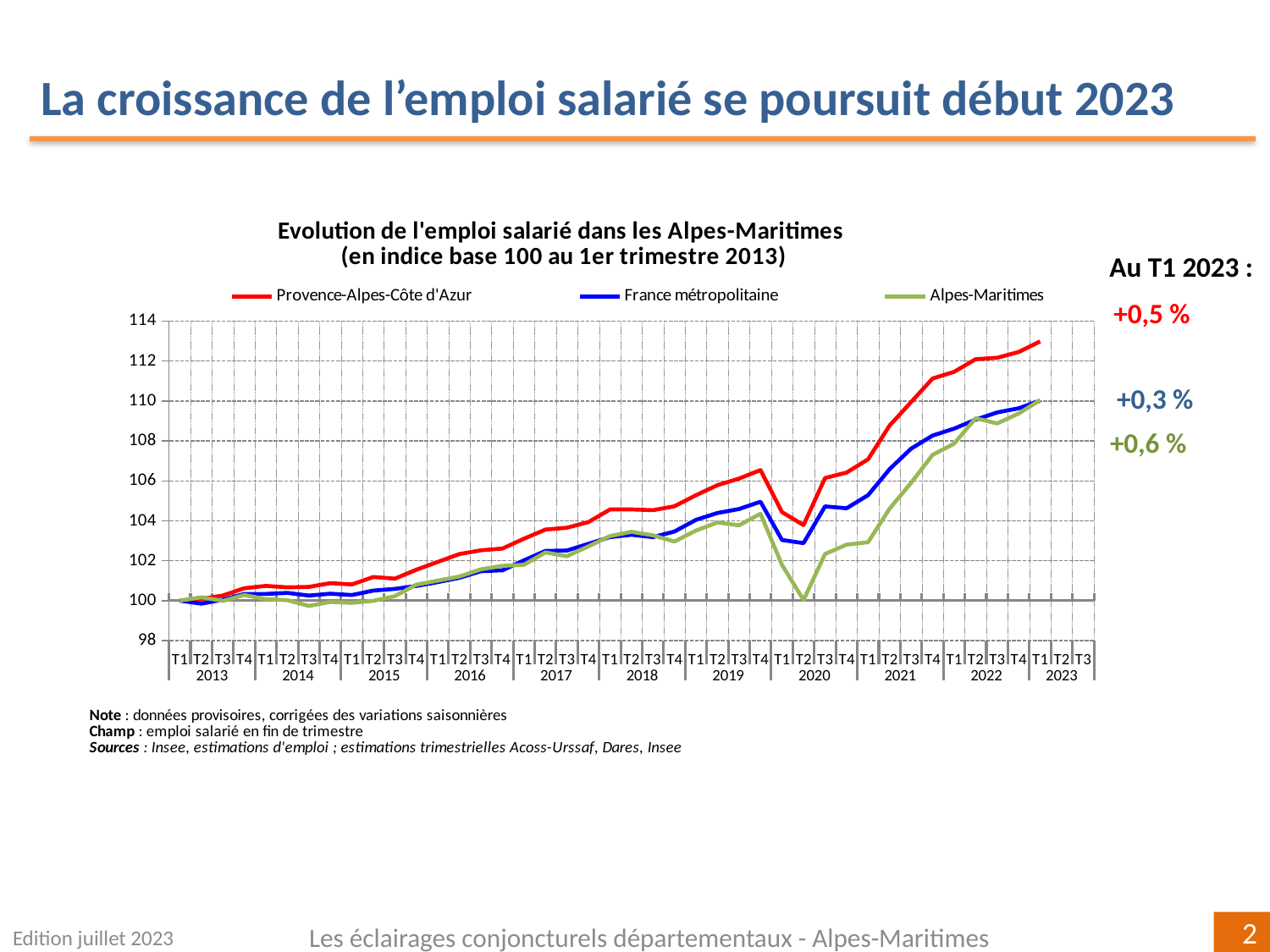
Which series has the highest value at T1 2023? Provence-Alpes-Côte d'Azur What growth rate is shown for Alpes-Maritimes at T1 2023? +0,6 % What growth rate is shown for Provence-Alpes-Côte d'Azur at T1 2023? +0,5 % Is the value for Alpes-Maritimes at T2 2020 greater or less than 102? less What colour is the line for Alpes-Maritimes? green Which series has the lowest value at T2 2020? Alpes-Maritimes Is the value for Provence-Alpes-Côte d'Azur at T1 2023 greater or less than 112? greater What kind of chart is shown on the slide? line chart What is the index value of all three series at T1 2013? 100 What is the title of the chart? Evolution de l'emploi salarié dans les Alpes-Maritimes (en indice base 100 au 1er trimestre 2013) How many series does the legend list? 3 What growth rate is shown for France métropolitaine at T1 2023? +0,3 %